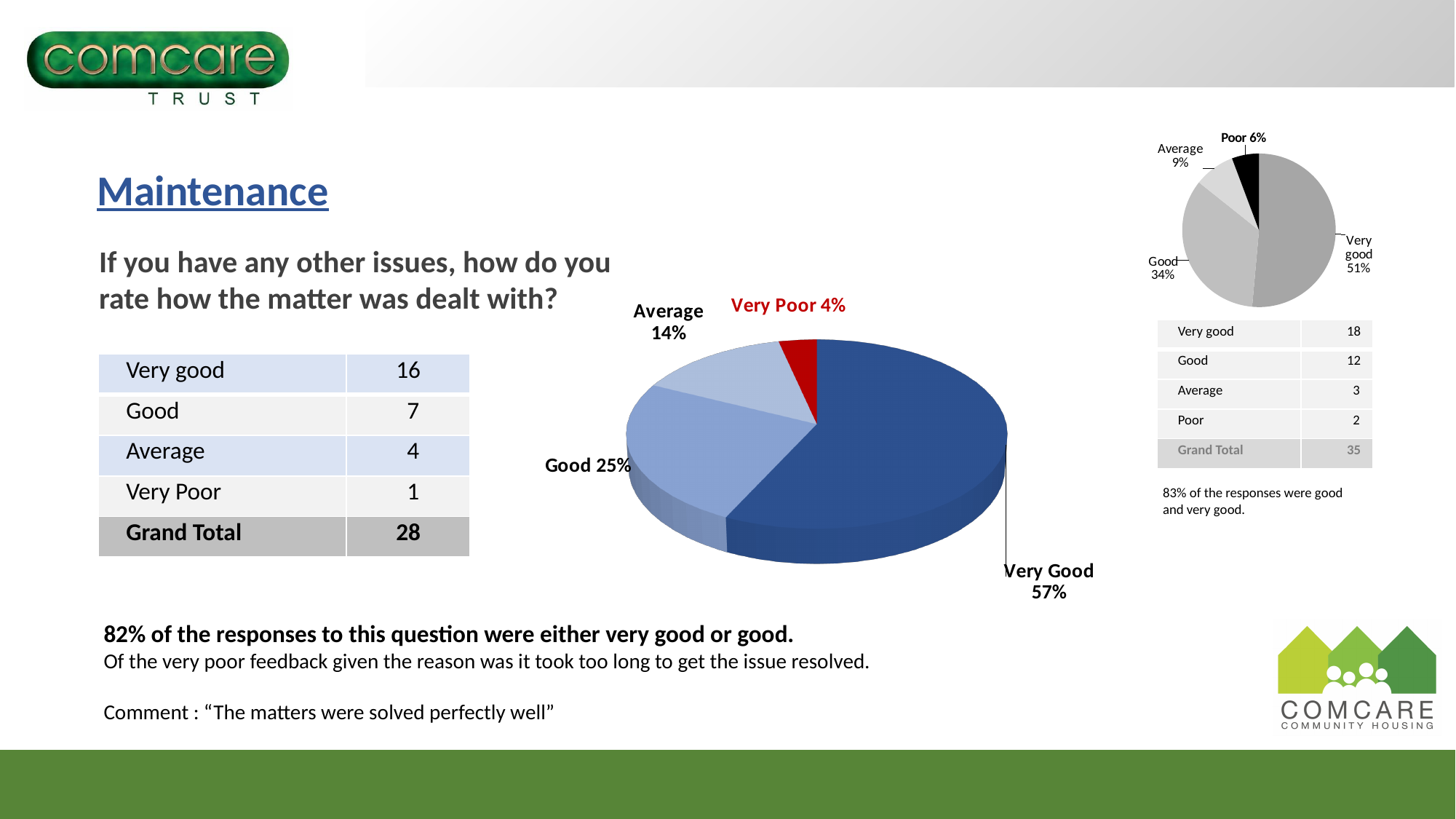
On the small pie chart in the top right of the slide, which category has the smallest slice? Poor On the small pie chart in the top right of the slide, what is the difference in percentage points between Very good and Good? 17 What kind of chart is the large chart in the centre of the slide? Pie chart On the large pie chart in the centre of the slide, what share does Very Poor have? 4% On the large pie chart in the centre of the slide, which category has the smallest slice? Very Poor On the large pie chart in the centre of the slide, what share does Average have? 14% On the small pie chart in the top right of the slide, what share does Good have? 34% On the large pie chart in the centre of the slide, which category has the largest slice? Very Good On the large pie chart in the centre of the slide, how many slices are there? 4